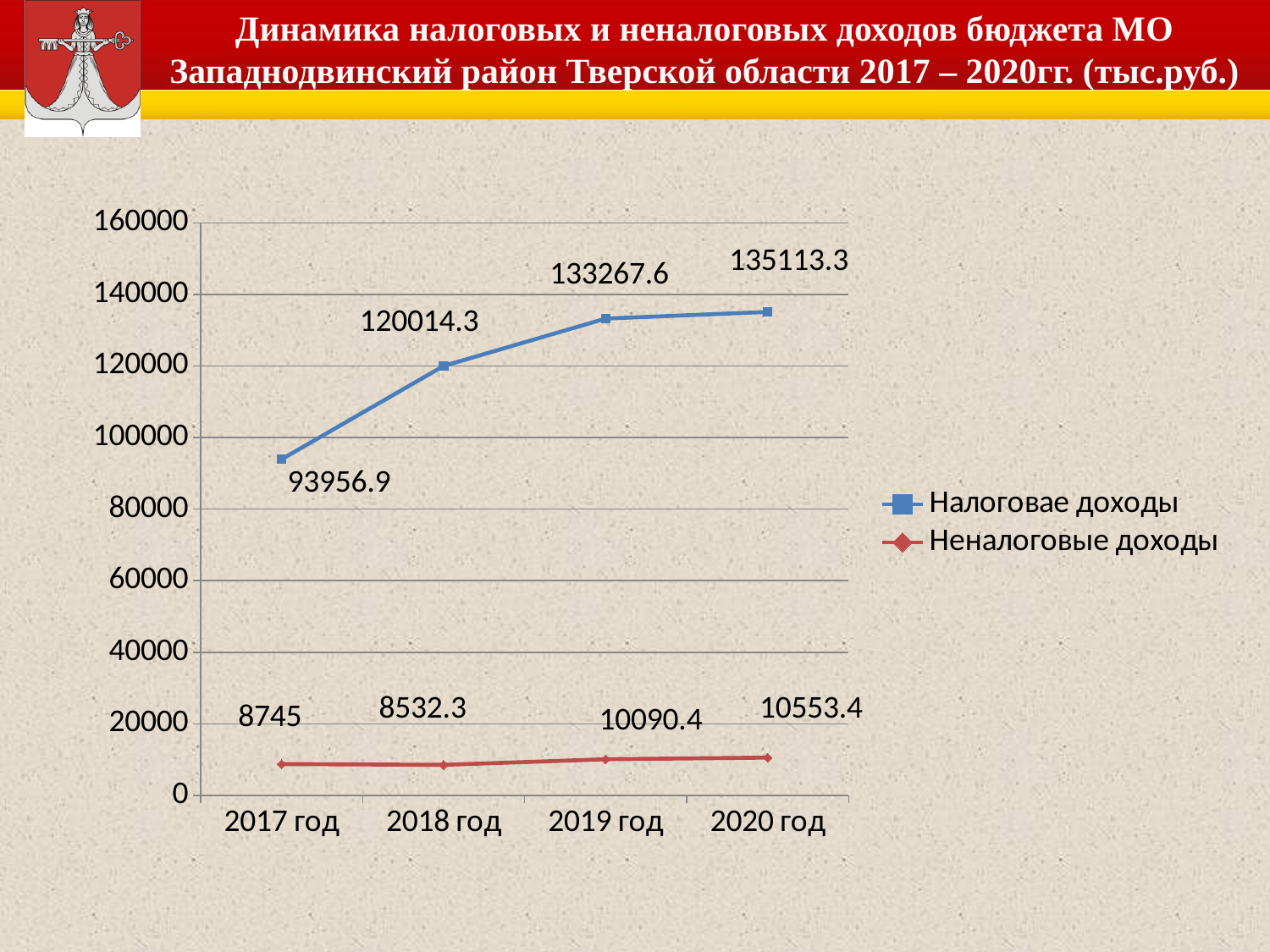
Which is larger: Налоговае доходы in 2018 год or Налоговае доходы in 2019 год? Налоговае доходы in 2019 год In which year is Неналоговые доходы lowest? 2018 год What is the value of Налоговае доходы for 2019 год? 133267.6 What is the difference between Налоговае доходы in 2020 год and 2017 год? 41156.4 What is the value of Налоговае доходы for 2017 год? 93956.9 What kind of chart is shown on the slide? line chart How many series does the legend list? 2 What is the difference between Неналоговые доходы in 2020 год and 2017 год? 1808.4 Is the value of Налоговае доходы for 2017 год greater or less than 100000? less What is the value of Неналоговые доходы for 2020 год? 10553.4 In which year is Налоговае доходы highest? 2020 год How many years are shown on the x axis? 4